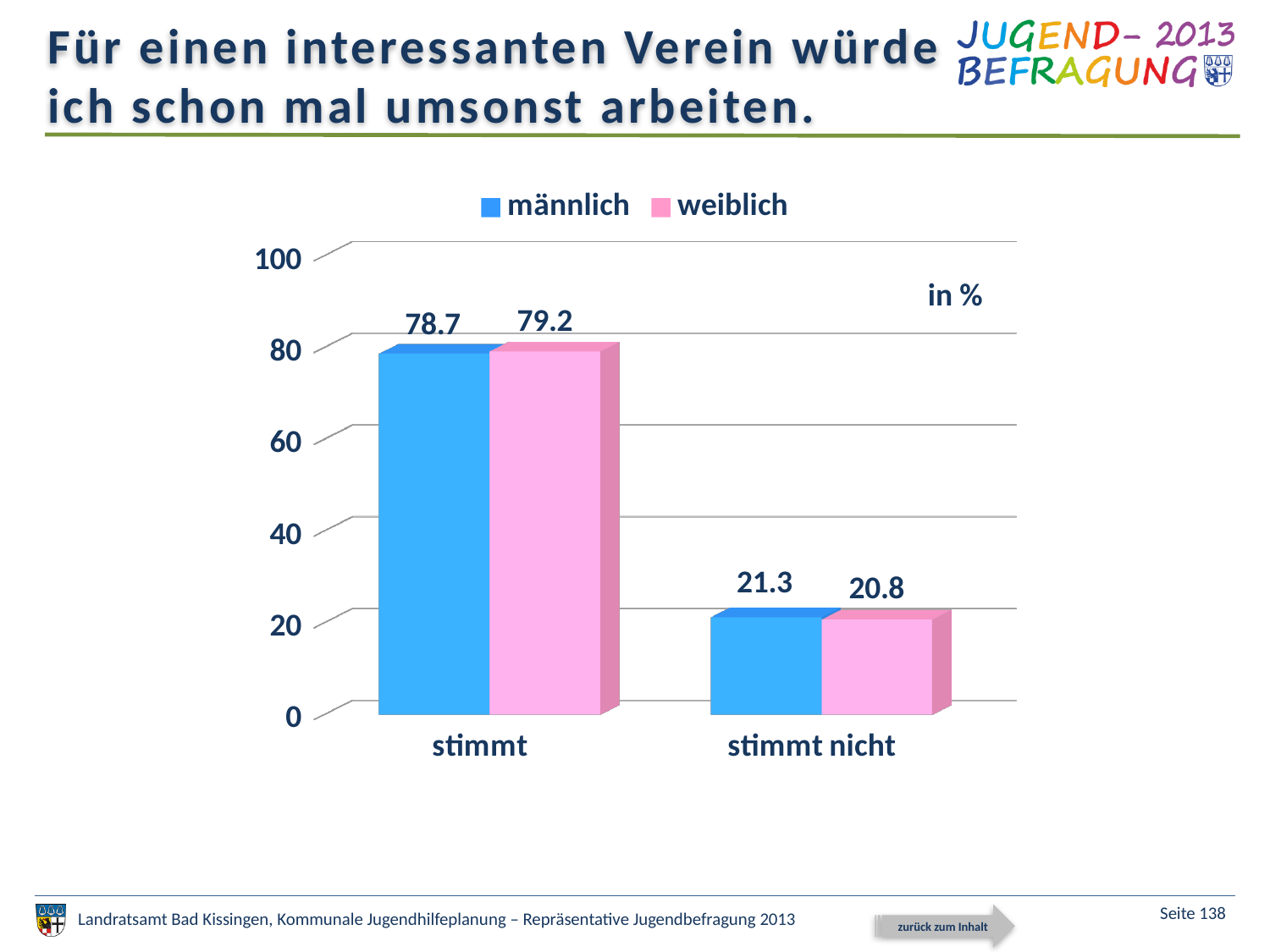
Is the männlich value for stimmt greater or less than 60? greater Which category has the lowest value for weiblich? stimmt nicht What is the value for männlich in the stimmt nicht category? 21.3 What kind of chart is shown on the slide? bar chart How many series does the legend list? 2 What is the value for weiblich in the stimmt nicht category? 20.8 How many categories are shown on the x axis? 2 What is the difference between the weiblich values for stimmt and stimmt nicht? 58.4 What is the value for weiblich in the stimmt category? 79.2 What is the difference between the männlich and weiblich values in the stimmt nicht category? 0.5 Which category has the highest value for männlich? stimmt What is the value for männlich in the stimmt category? 78.7